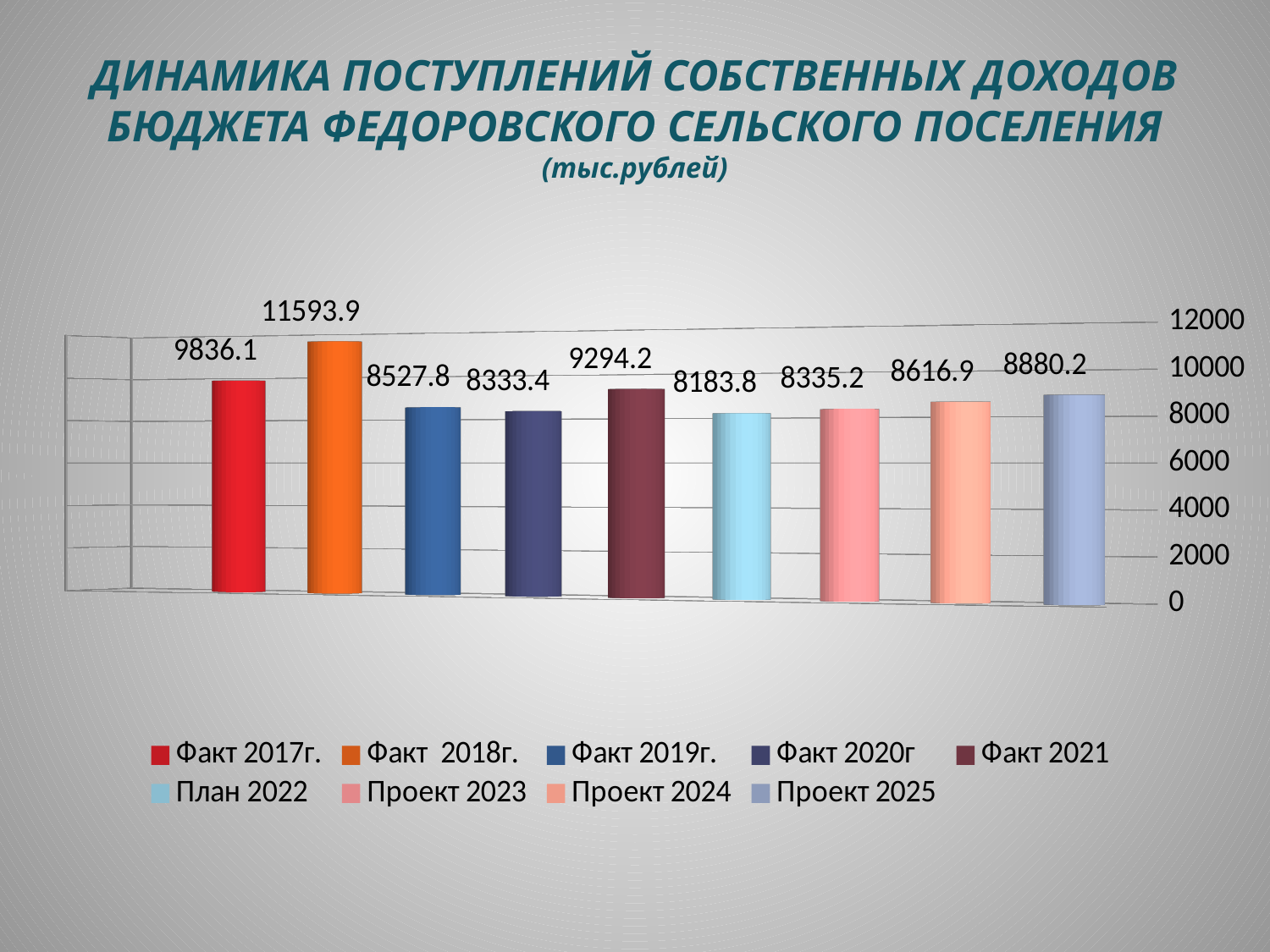
What kind of chart is shown on the slide? bar chart Is the value for Факт 2017г. greater or less than 8000? greater How many bars are plotted on the chart? 9 What is the value for Факт 2018г.? 11593.9 Which is larger, the value for Факт 2021 or the value for Факт 2019г.? Факт 2021 What is the difference between the values for Проект 2025 and Проект 2024? 263.3 Which series has the highest value? Факт 2018г. What is the value for Проект 2025? 8880.2 Which series has the lowest value? План 2022 How many series does the legend list? 9 What is the difference between the values for Факт 2018г. and Факт 2017г.? 1757.8 What is the value for План 2022? 8183.8